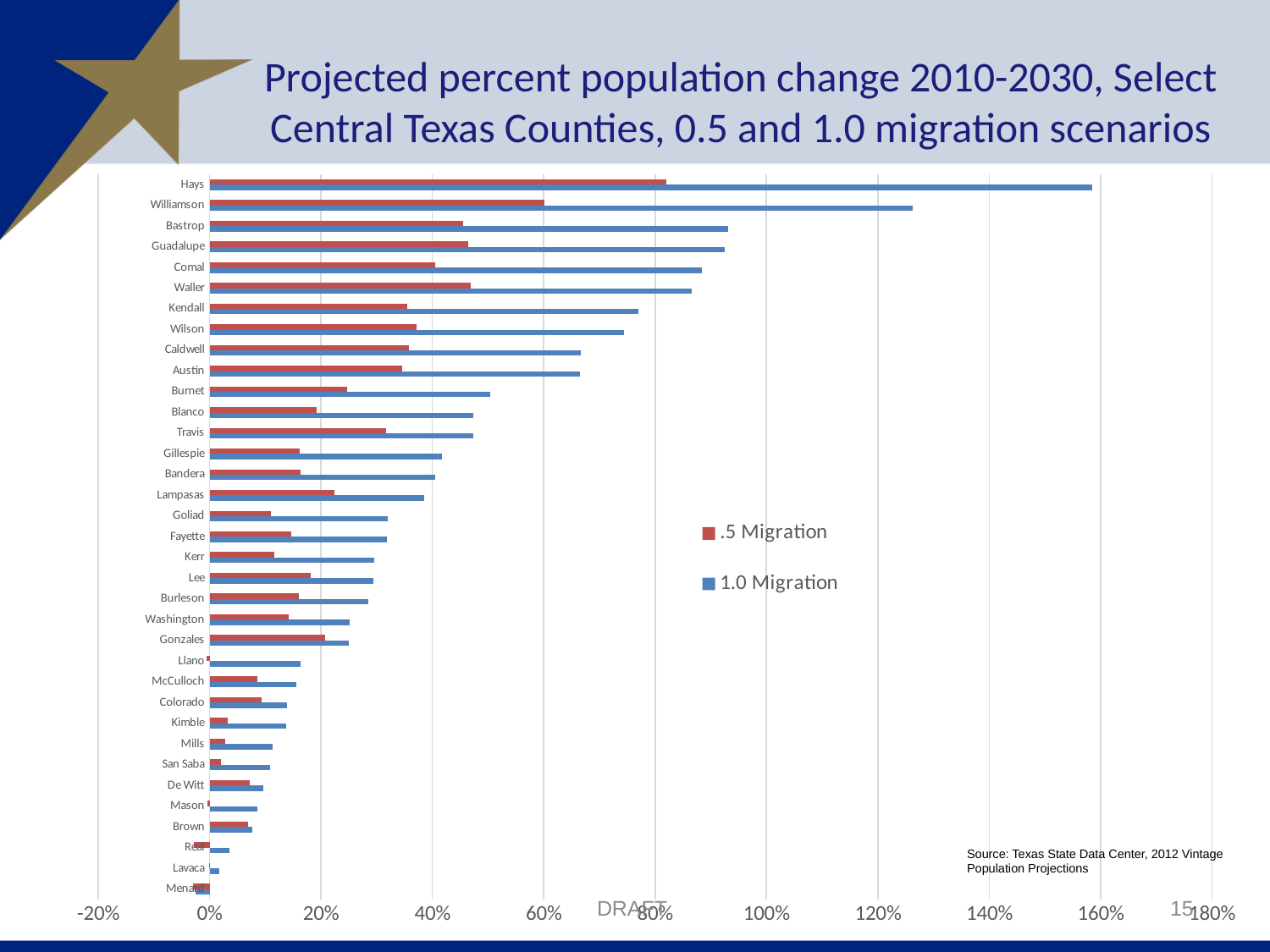
Is the 1.0 Migration value for Travis greater or less than 40%? greater How many series does the legend list? 2 What kind of chart is shown on the slide? bar chart Which county has the highest value for the 1.0 Migration series? Hays How many counties are plotted on the chart? 35 Is the .5 Migration value for Menard greater or less than 0%? less Which colour represents the 1.0 Migration series? blue Which county has the larger .5 Migration value, Travis or Blanco? Travis Is the 1.0 Migration value for Hays greater or less than 140%? greater Which county has the highest value for the .5 Migration series? Hays Which is larger for Williamson: the .5 Migration value or the 1.0 Migration value? 1.0 Migration